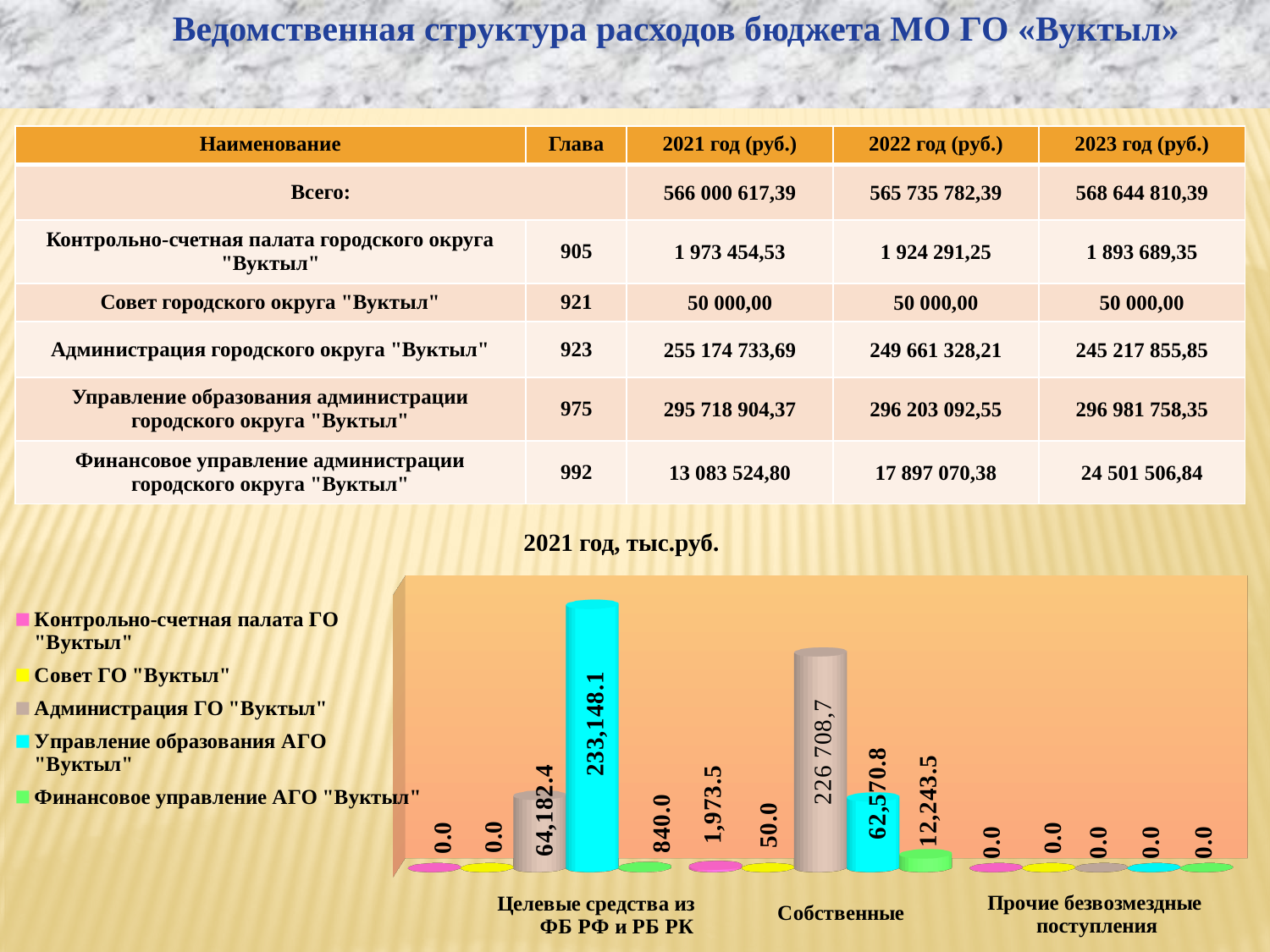
Which series has the highest value in the category Собственные? Администрация ГО "Вуктыл" What is the value for Финансовое управление АГО "Вуктыл" in the category Собственные? 12,243.5 What is the value for Контрольно-счетная палата ГО "Вуктыл" in the category Собственные? 1,973.5 What is the value for Совет ГО "Вуктыл" in the category Собственные? 50.0 What is the value for Управление образования АГО "Вуктыл" in the category Целевые средства из ФБ РФ и РБ РК? 233,148.1 What is the value for Администрация ГО "Вуктыл" in the category Целевые средства из ФБ РФ и РБ РК? 64,182.4 Which series has the highest value in the category Целевые средства из ФБ РФ и РБ РК? Управление образования АГО "Вуктыл" How many categories are shown on the x axis of the chart? 3 What kind of chart is shown on the slide? bar chart What is the title of the chart on the slide? 2021 год, тыс.руб. In the category Собственные, which is larger: the value for Управление образования АГО "Вуктыл" or the value for Финансовое управление АГО "Вуктыл"? Управление образования АГО "Вуктыл" How many series does the chart legend list? 5